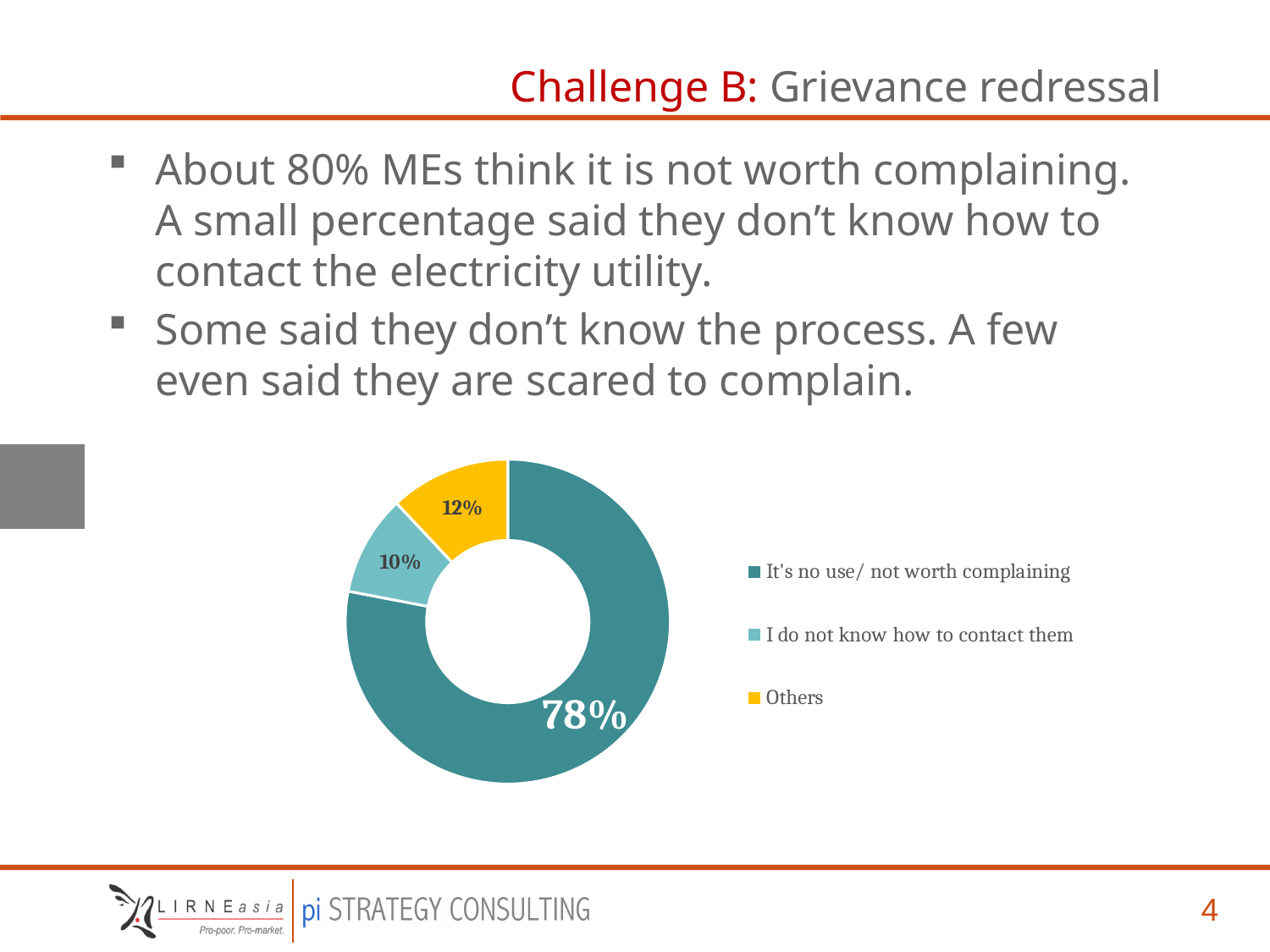
What percentage of respondents fall under "Others"? 12% Which category has the smallest share of the chart? I do not know how to contact them What percentage of respondents said "I do not know how to contact them"? 10% What colour is the "Others" segment of the chart? Yellow What kind of chart is shown on the slide? Doughnut chart What is the difference in percentage points between "It's no use/ not worth complaining" and "Others"? 66 What percentage of respondents said "It's no use/ not worth complaining"? 78% What is the difference in percentage points between "Others" and "I do not know how to contact them"? 2 How many categories does the chart show? 3 Which is larger: the share for "Others" or the share for "I do not know how to contact them"? Others Which category has the largest share of the chart? It's no use/ not worth complaining How many entries does the legend list? 3